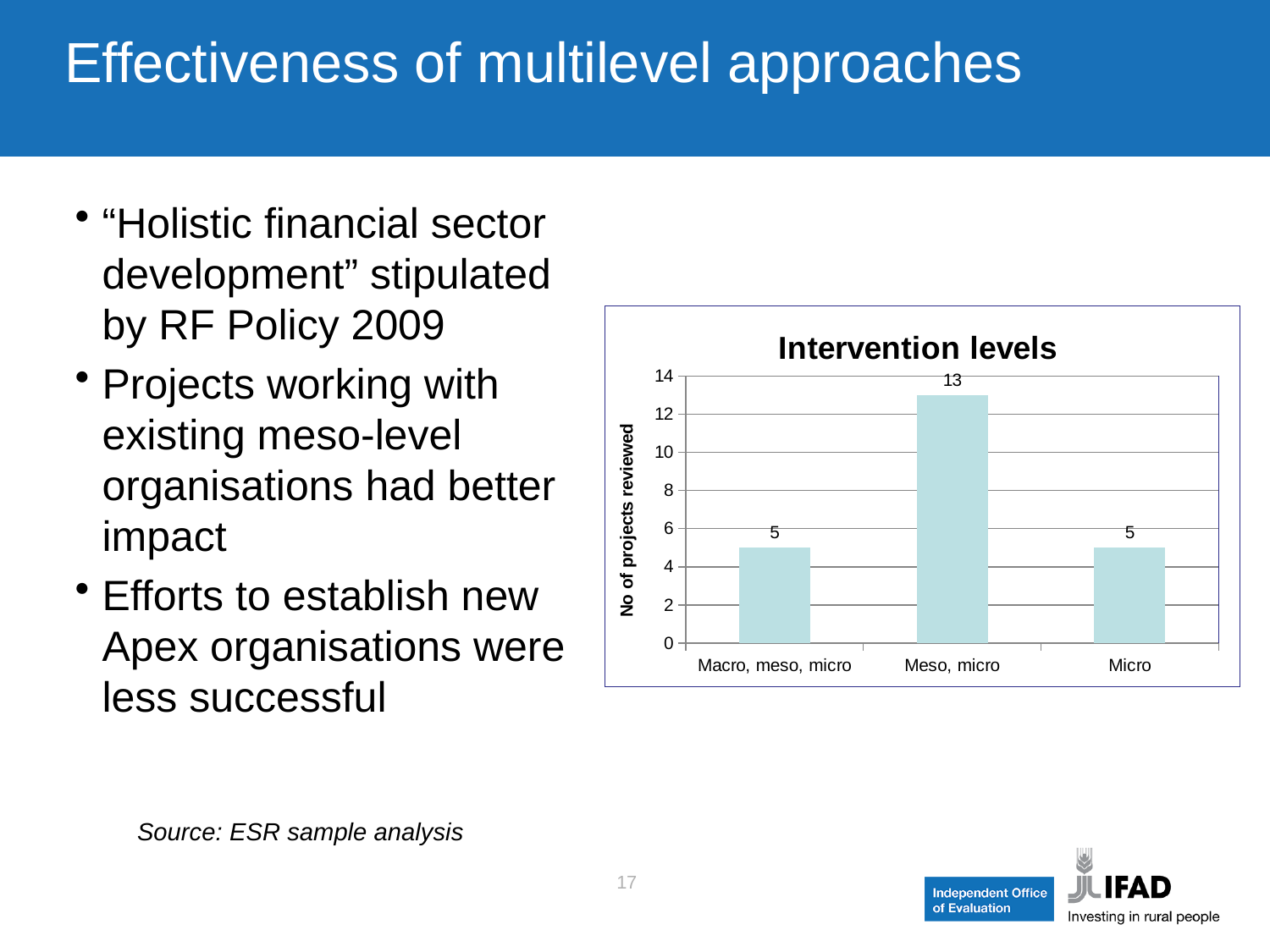
What is the number of projects reviewed for "Micro"? 5 How many categories are shown on the x axis of the chart? 3 What is the title of the chart? Intervention levels What is the number of projects reviewed for "Meso, micro"? 13 What is the total number of projects reviewed across all three intervention levels? 23 What is the number of projects reviewed for "Macro, meso, micro"? 5 What is the label of the vertical axis of the chart? No of projects reviewed Which intervention level has the highest number of projects reviewed? Meso, micro Which has more projects reviewed: "Meso, micro" or "Macro, meso, micro"? Meso, micro What kind of chart is shown on the slide? Bar chart What is the difference between the number of projects reviewed for "Meso, micro" and for "Micro"? 8 Is the value for "Meso, micro" greater or less than 10? greater